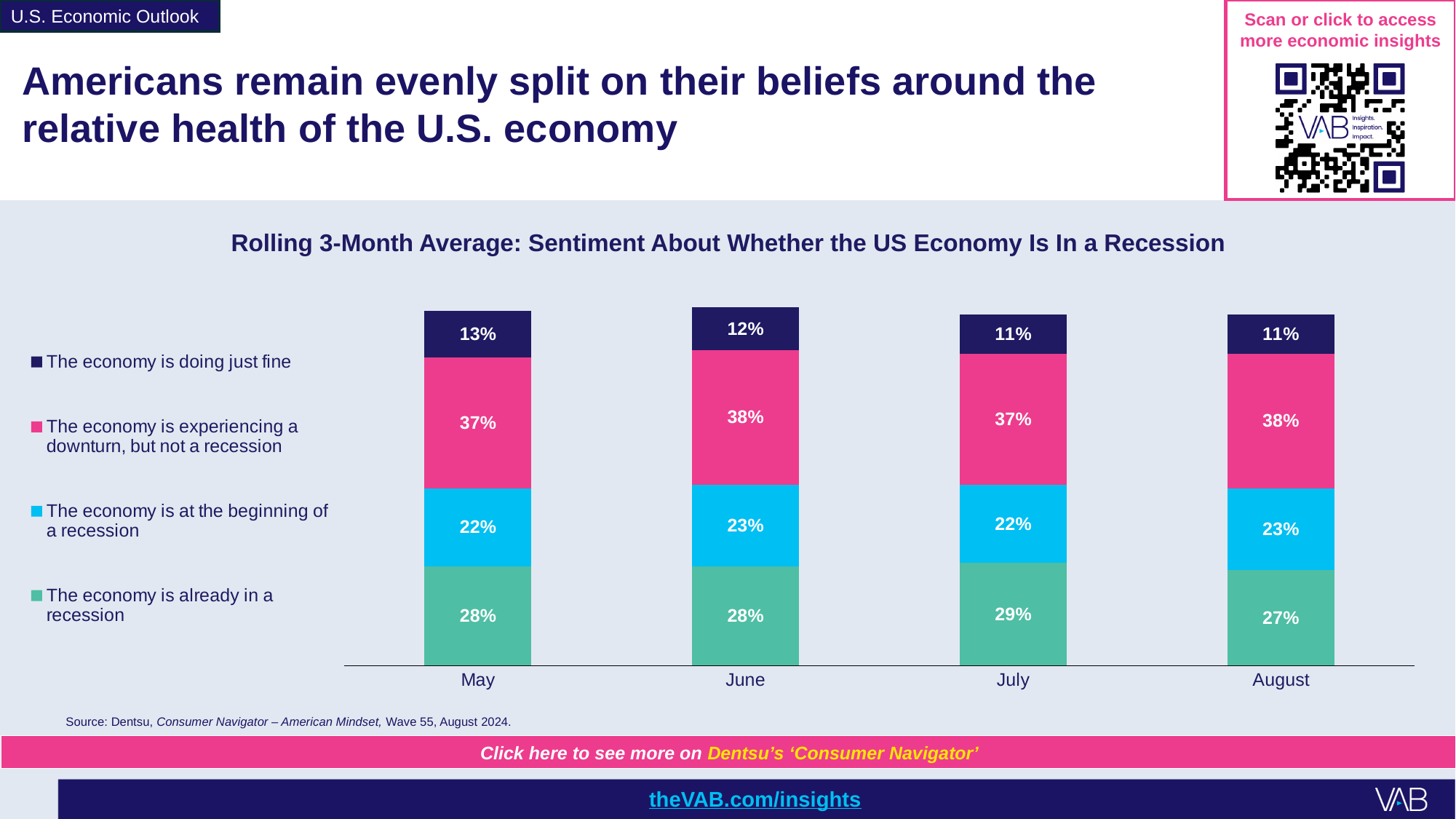
Which month has the highest share saying the economy is doing just fine? May In August, what share said the economy is experiencing a downturn, but not a recession? 38% How many months are shown on the x axis of the chart? 4 What percentage in June said the economy is at the beginning of a recession? 23% What type of chart is shown on the slide? Stacked bar chart Which month has the lowest share saying the economy is already in a recession? August What percentage of respondents in May said the economy is already in a recession? 28% What is the value for 'The economy is doing just fine' in July? 11% Does the share saying the economy is doing just fine rise or fall from May to August? Fall In May, how many percentage points higher is 'experiencing a downturn, but not a recession' than 'doing just fine'? 24 percentage points In June, which is larger: the share saying the economy is experiencing a downturn but not a recession, or the share saying it is already in a recession? Experiencing a downturn, but not a recession How many series does the chart's legend list? 4